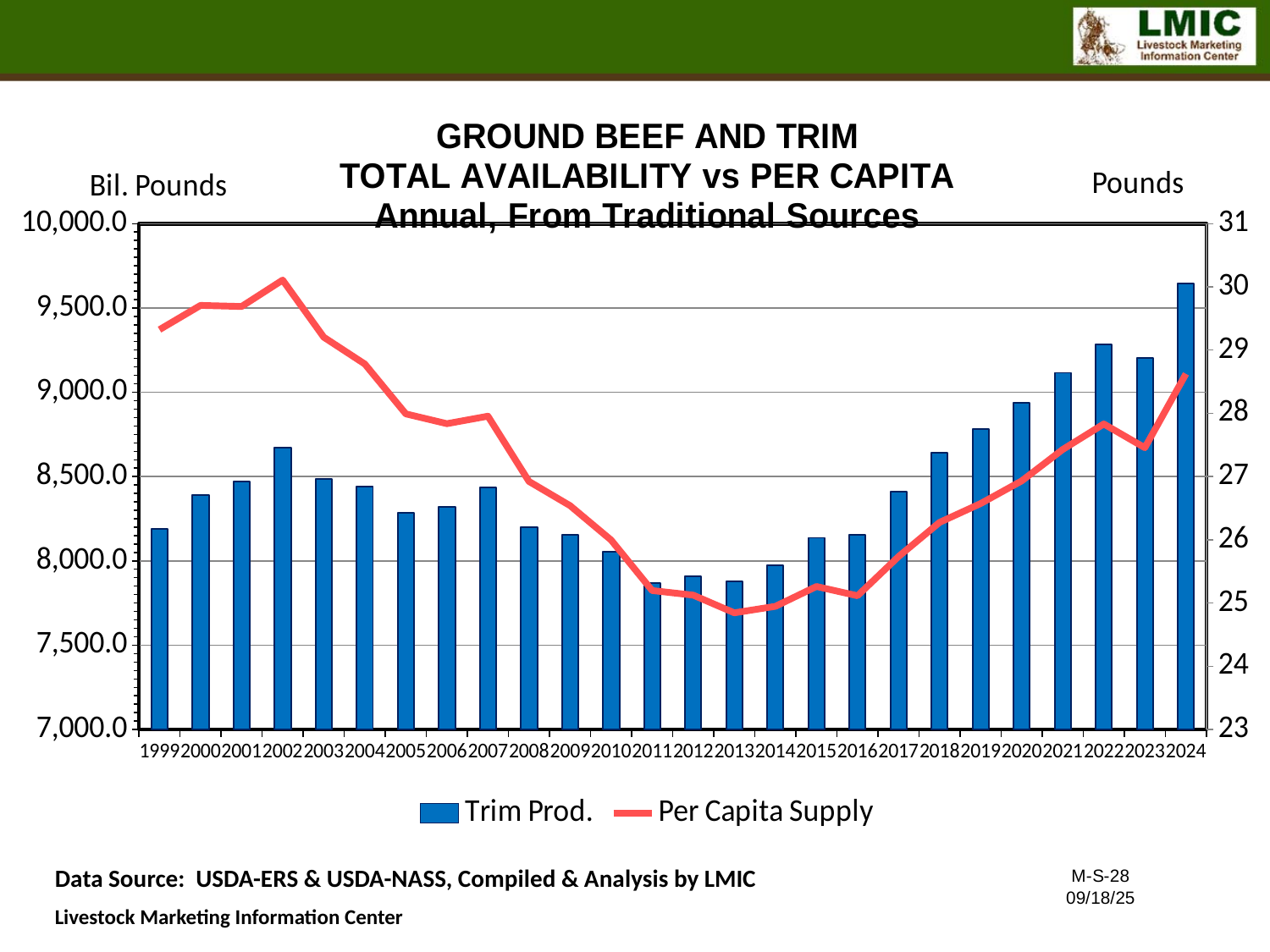
How many series does the legend list? 2 Which year has the highest Trim Prod. bar? 2024 Is the Trim Prod. value for 2024 greater or less than 9,500.0? greater What is the label on the left vertical axis? Bil. Pounds Is the Trim Prod. value for 2013 greater or less than 8,000.0? less Which year has the larger Trim Prod. bar, 2002 or 2024? 2024 Does the Per Capita Supply line rise or fall from 2002 to 2013? fall What kind of chart is shown on the slide? A combination bar and line chart Is the Per Capita Supply value for 2024 greater or less than 28? greater How many years are plotted along the x axis? 26 In which year does the Per Capita Supply line reach its highest point? 2002